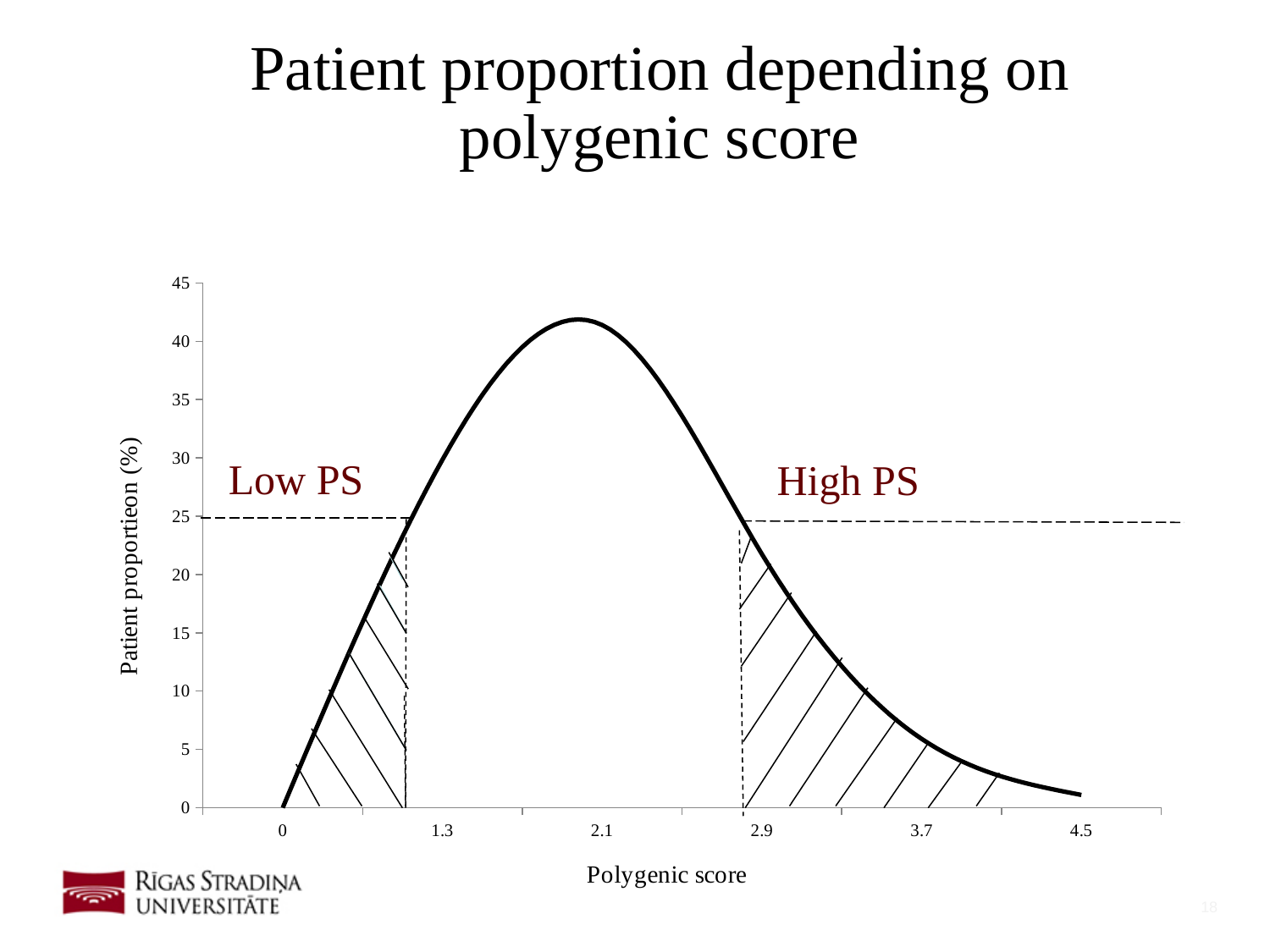
Is the peak value of the curve greater or less than 40? greater What is the patient proportion at a polygenic score of 0? 0 Is the patient proportion at a polygenic score of 1.3 greater or less than 20? greater What is the title of the chart? Patient proportion depending on polygenic score What is the label of the y axis? Patient proportieon (%) Is the patient proportion at a polygenic score of 4.5 greater or less than 5? less What kind of chart is shown on the slide? line chart Which is larger, the patient proportion at a polygenic score of 2.1 or at 4.5? 2.1 Does the patient proportion rise or fall as the polygenic score increases from 2.9 to 4.5? fall